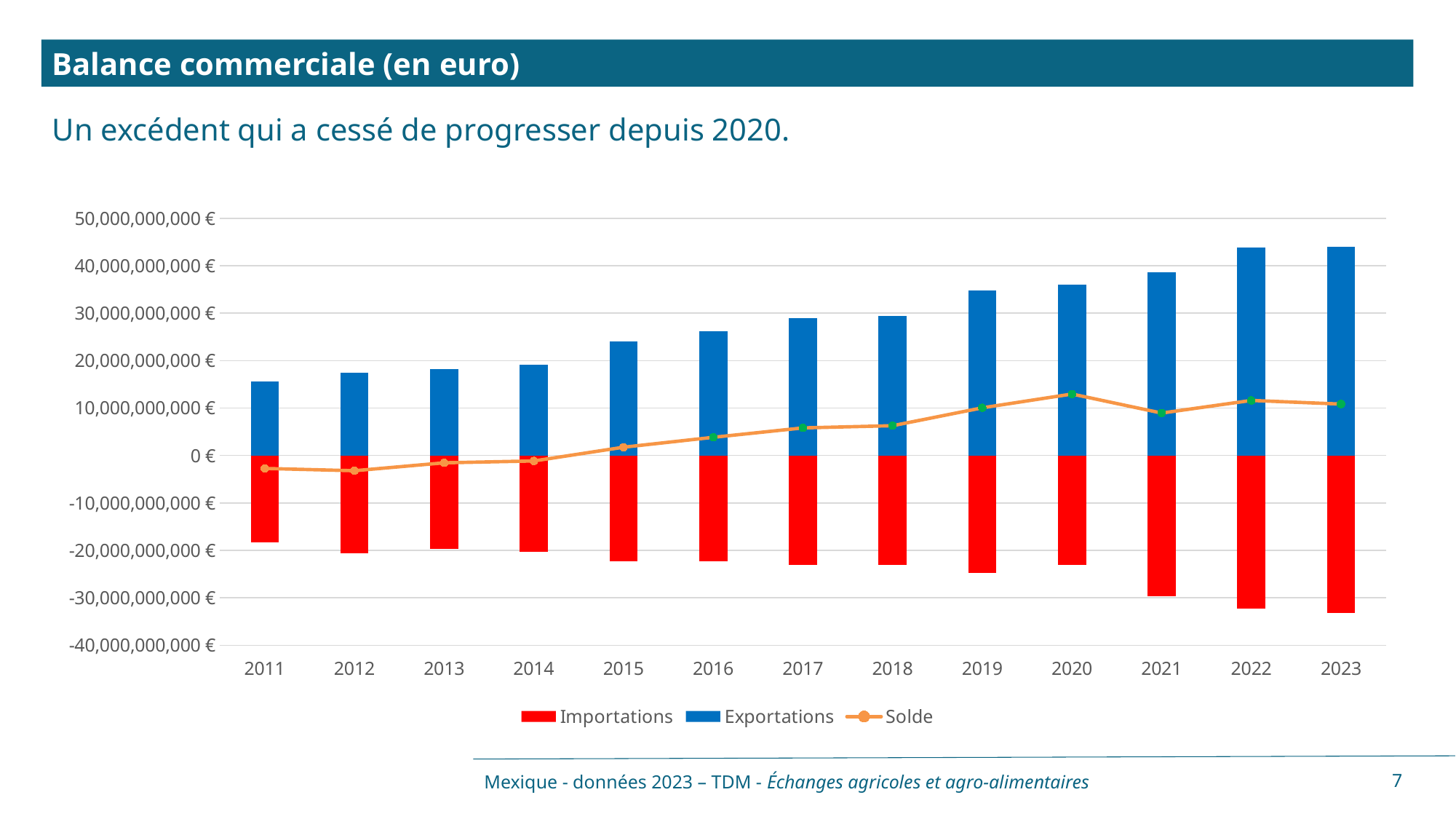
Is the Exportations value for 2020 greater or less than 30,000,000,000 €? greater Is the Exportations value for 2011 greater or less than 20,000,000,000 €? less Which year has the lowest Exportations value? 2011 How many series does the chart legend list? 3 Do the Exportations values generally rise or fall from 2011 to 2023? rise In which year does the Solde line reach its highest point? 2020 Is the Solde value for 2012 greater or less than 0 €? less How many years are shown on the x axis of the chart? 13 Which year has the larger Exportations value, 2016 or 2019? 2019 What kind of chart is shown on the slide? A bar chart combined with a line Which colour represents Importations in the chart? Red